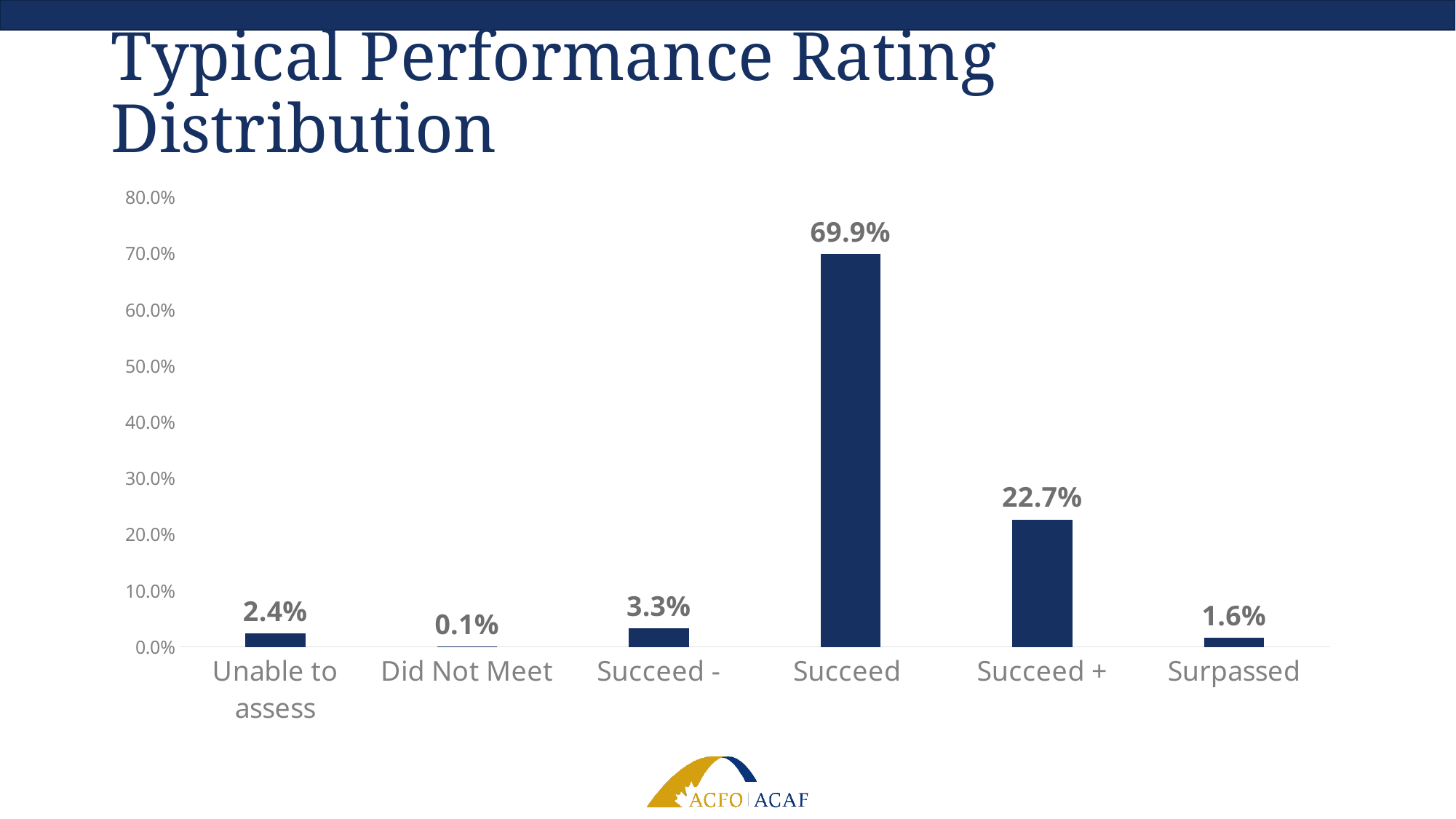
What is the difference between the values for Succeed and Succeed +? 47.2% Which category has the highest value? Succeed What is the title of the slide? Typical Performance Rating Distribution Is the value for Succeed + greater or less than 20.0%? greater Which is larger, the value for Succeed - or the value for Unable to assess? Succeed - What is the value for Succeed? 69.9% What kind of chart is shown on the slide? bar chart What is the value for Unable to assess? 2.4% What is the value for Surpassed? 1.6% Which category has the lowest value? Did Not Meet How many categories are shown on the x axis? 6 What is the value for Succeed +? 22.7%